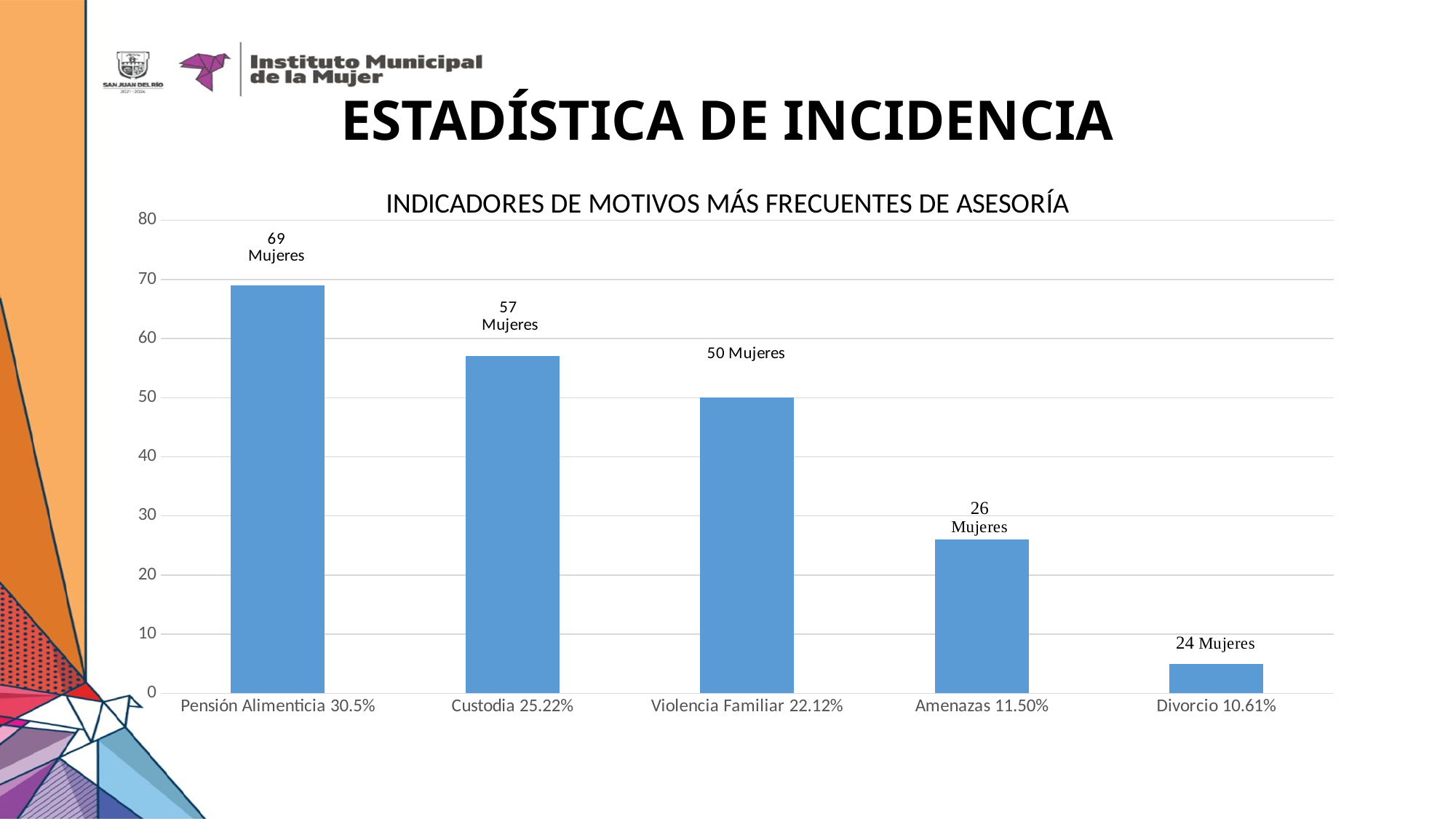
Which category has the highest value? Pensión Alimenticia What is the title of the chart? INDICADORES DE MOTIVOS MÁS FRECUENTES DE ASESORÍA What is the value shown for Amenazas? 26 Mujeres Do the values rise or fall from left to right along the x axis? fall What is the value shown for Pensión Alimenticia? 69 Mujeres What is the value shown for Custodia? 57 Mujeres How many categories are plotted in the chart? 5 What is the value shown for Violencia Familiar? 50 Mujeres Which is larger, the value for Violencia Familiar or the value for Amenazas? Violencia Familiar What is the difference between the values for Pensión Alimenticia and Custodia? 12 Which category has the lowest value? Divorcio What kind of chart is shown on the slide? bar chart